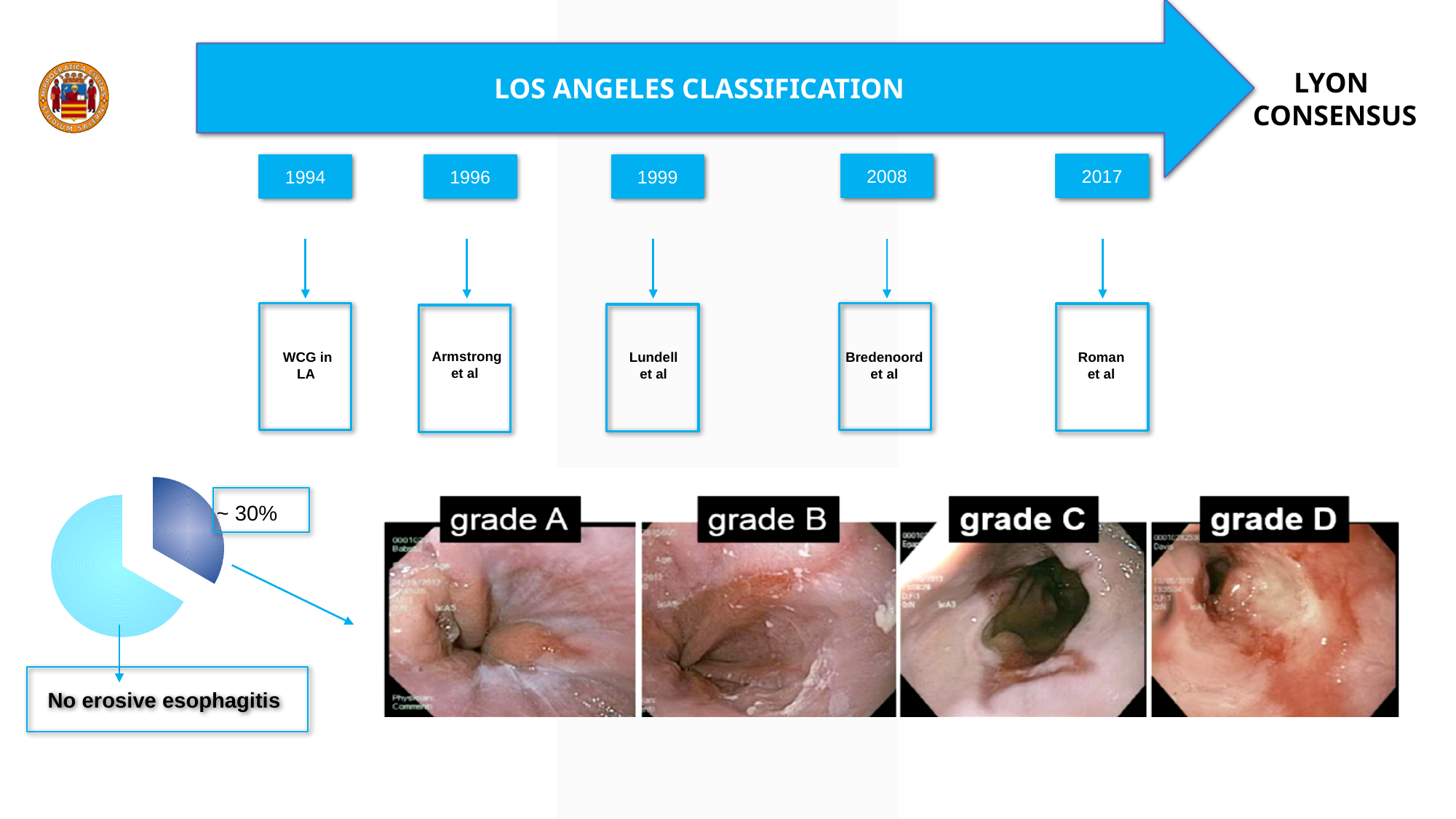
Which slice of the pie chart is pulled out (exploded) from the rest of the pie? the dark blue slice What value label is attached to the dark blue slice of the pie chart? ~ 30% Is the share of the dark blue slice of the pie chart greater or less than 50%? less Is the share of the light blue slice of the pie chart greater or less than 50%? greater Which slice of the pie chart is larger, the light blue slice or the dark blue slice? the light blue slice What does the light blue slice of the pie chart represent, according to the label it points to? No erosive esophagitis What kind of chart is shown at the bottom left of the slide? pie chart Which slice of the pie chart is the largest? the light blue slice (No erosive esophagitis) How many slices does the pie chart at the bottom left have? 2 Which slice of the pie chart is the smallest? the dark blue slice (~ 30%)